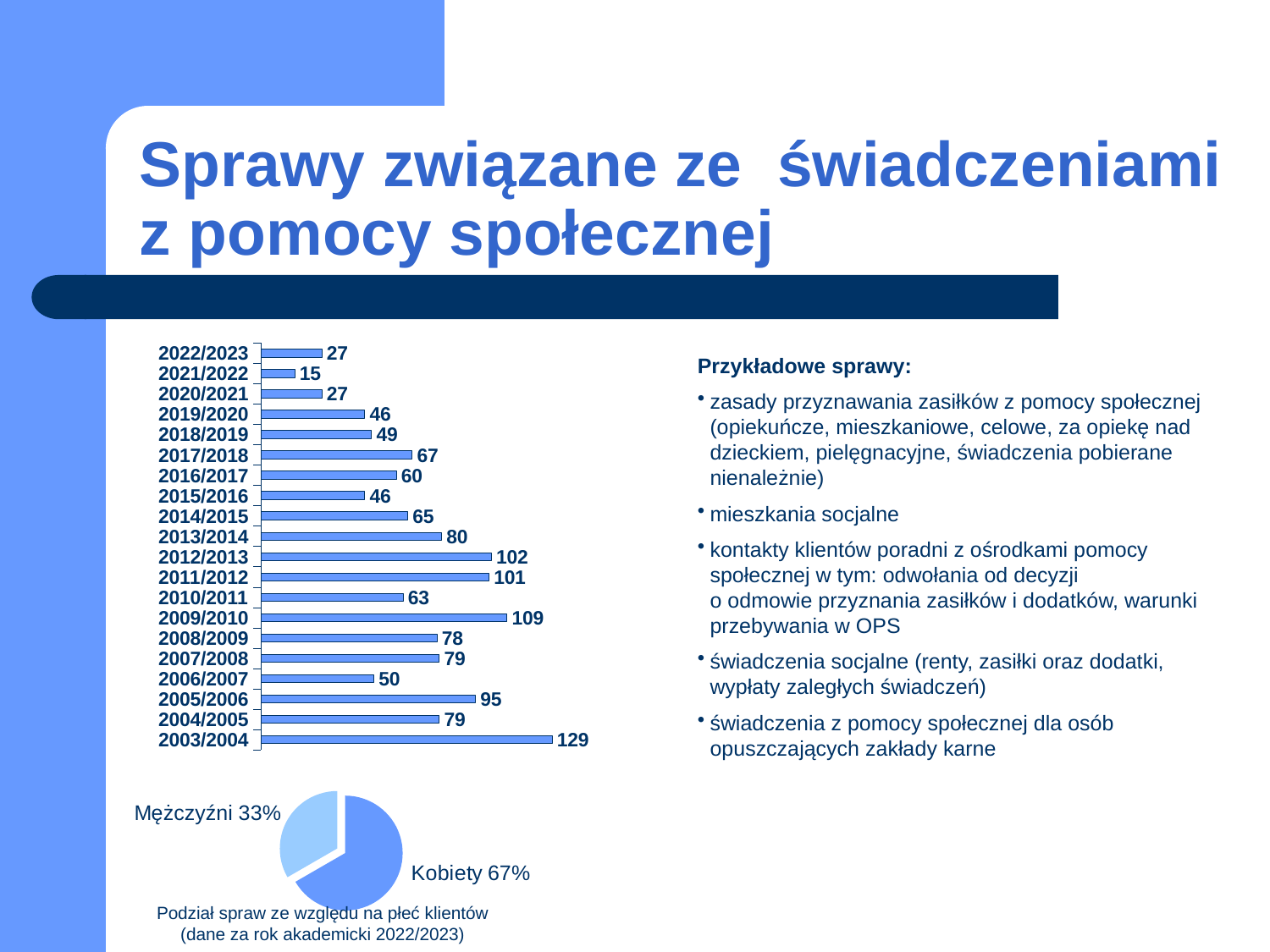
What kind of chart shows the split of cases by client gender? pie chart How many academic years are shown in the bar chart? 20 In the pie chart, what share is labelled Mężczyźni? 33% In the bar chart, what is the difference between the values for 2009/2010 and 2010/2011? 46 What kind of chart shows the values by academic year? bar chart In the bar chart, what is the value for 2021/2022? 15 In the pie chart, what share is labelled Kobiety? 67% In the bar chart, what is the value for 2003/2004? 129 In the bar chart, which academic year has the lowest value? 2021/2022 In the bar chart, which academic year has the highest value? 2003/2004 In the bar chart, which is larger: the value for 2017/2018 or the value for 2016/2017? 2017/2018 In the bar chart, what is the value for 2012/2013? 102